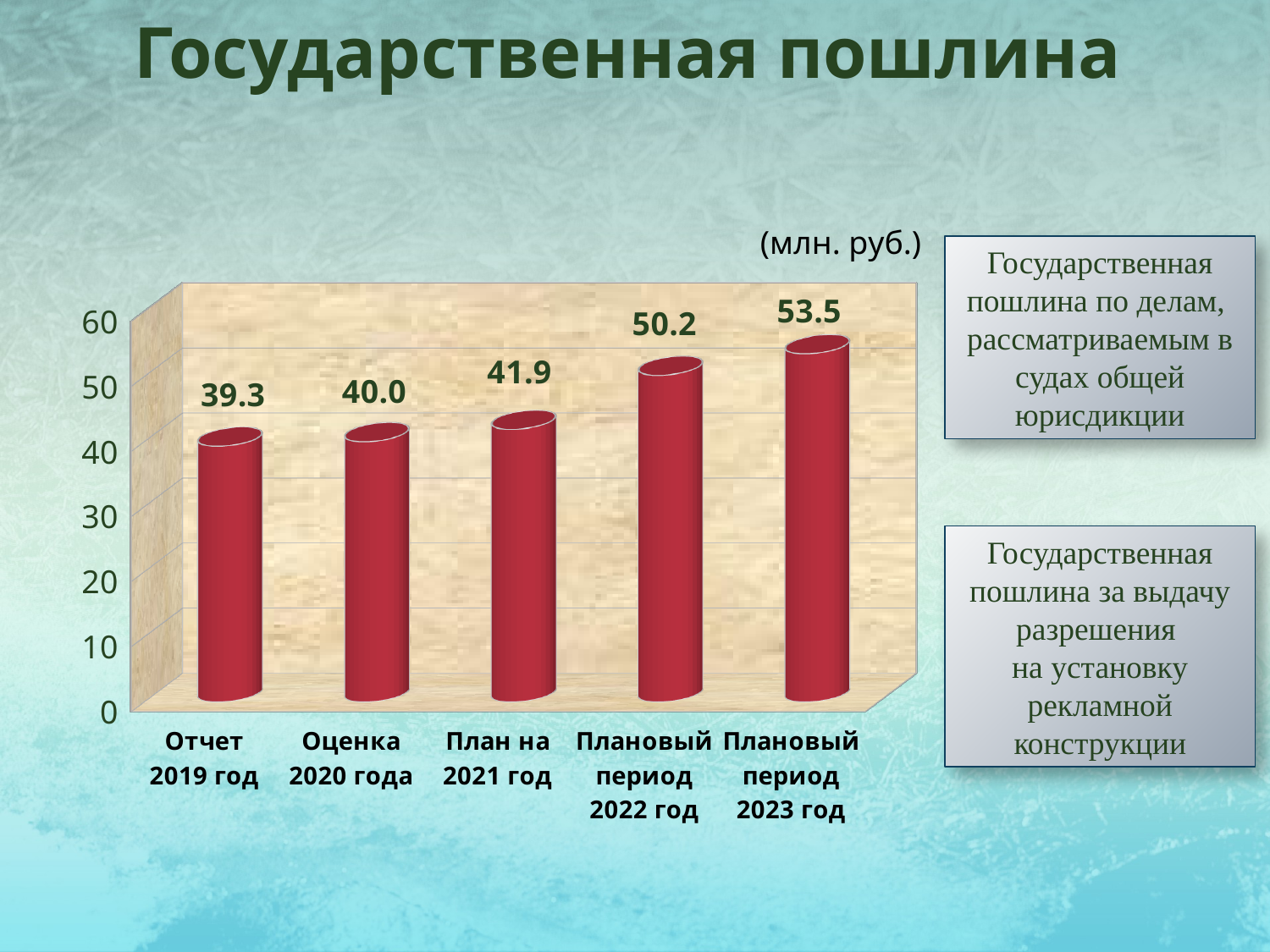
What is the difference between the values for Плановый период 2022 год and Оценка 2020 года? 10.2 How many categories are shown on the chart? 5 Which is larger, the value for План на 2021 год or the value for Плановый период 2022 год? Плановый период 2022 год What is the value for Плановый период 2023 год? 53.5 What unit is indicated for the chart values? млн. руб. Which category has the lowest value? Отчет 2019 год What kind of chart is shown on the slide? bar chart Do the values rise or fall from Отчет 2019 год to Плановый период 2023 год? rise Which category has the highest value? Плановый период 2023 год Is the value for Плановый период 2023 год greater or less than 50? greater What is the value for Отчет 2019 год? 39.3 What is the value for План на 2021 год? 41.9